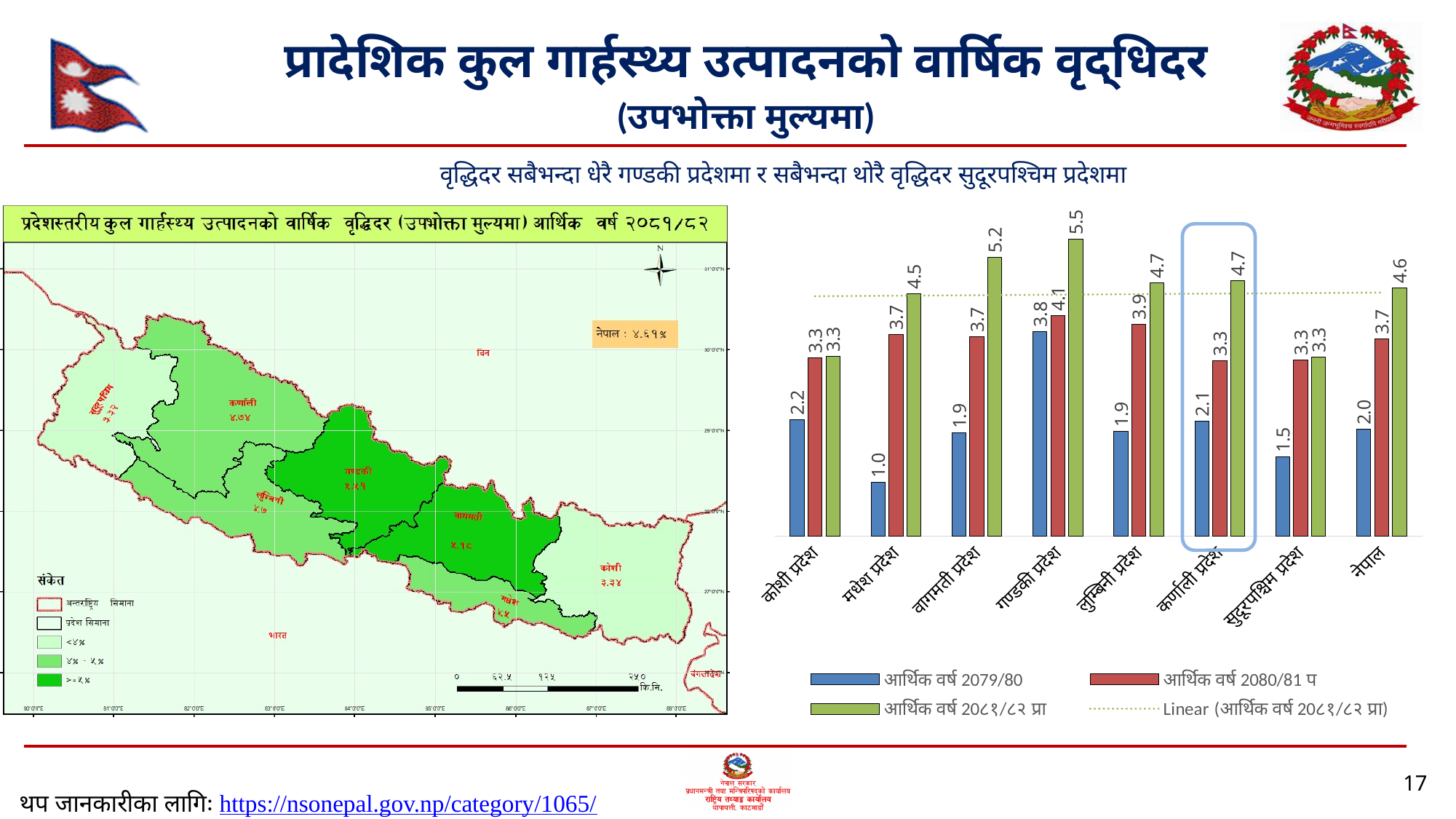
In the bar chart on the right, what colour are the bars for the आर्थिक वर्ष 2079/80 series? Blue In the bar chart on the right, how many entries does the legend list? 4 In the bar chart on the right, what is the value for मधेश प्रदेश in the आर्थिक वर्ष 2079/80 series? 1.0 In the bar chart on the right, what is the value for सुदूरपश्चिम प्रदेश in the आर्थिक वर्ष 2079/80 series? 1.5 What kind of chart is shown on the right side of the slide? Bar chart In the bar chart on the right, which category has the lowest value in the आर्थिक वर्ष 2079/80 series? मधेश प्रदेश In the bar chart on the right, what is the value for गण्डकी प्रदेश in the आर्थिक वर्ष २०८१/८२ प्रा series? 5.5 In the bar chart on the right, how many categories are shown on the x axis? 8 In the bar chart on the right, which province has the highest value in the आर्थिक वर्ष २०८१/८२ प्रा series? गण्डकी प्रदेश In the bar chart on the right, what is the difference between the आर्थिक वर्ष २०८१/८२ प्रा values for बागमती प्रदेश and कोशी प्रदेश? 1.9 In the bar chart on the right, what is the value for नेपाल in the आर्थिक वर्ष 2080/81 प series? 3.7 In the bar chart on the right, which is larger for कर्णाली प्रदेश: the आर्थिक वर्ष 2080/81 प value or the आर्थिक वर्ष २०८१/८२ प्रा value? आर्थिक वर्ष २०८१/८२ प्रा